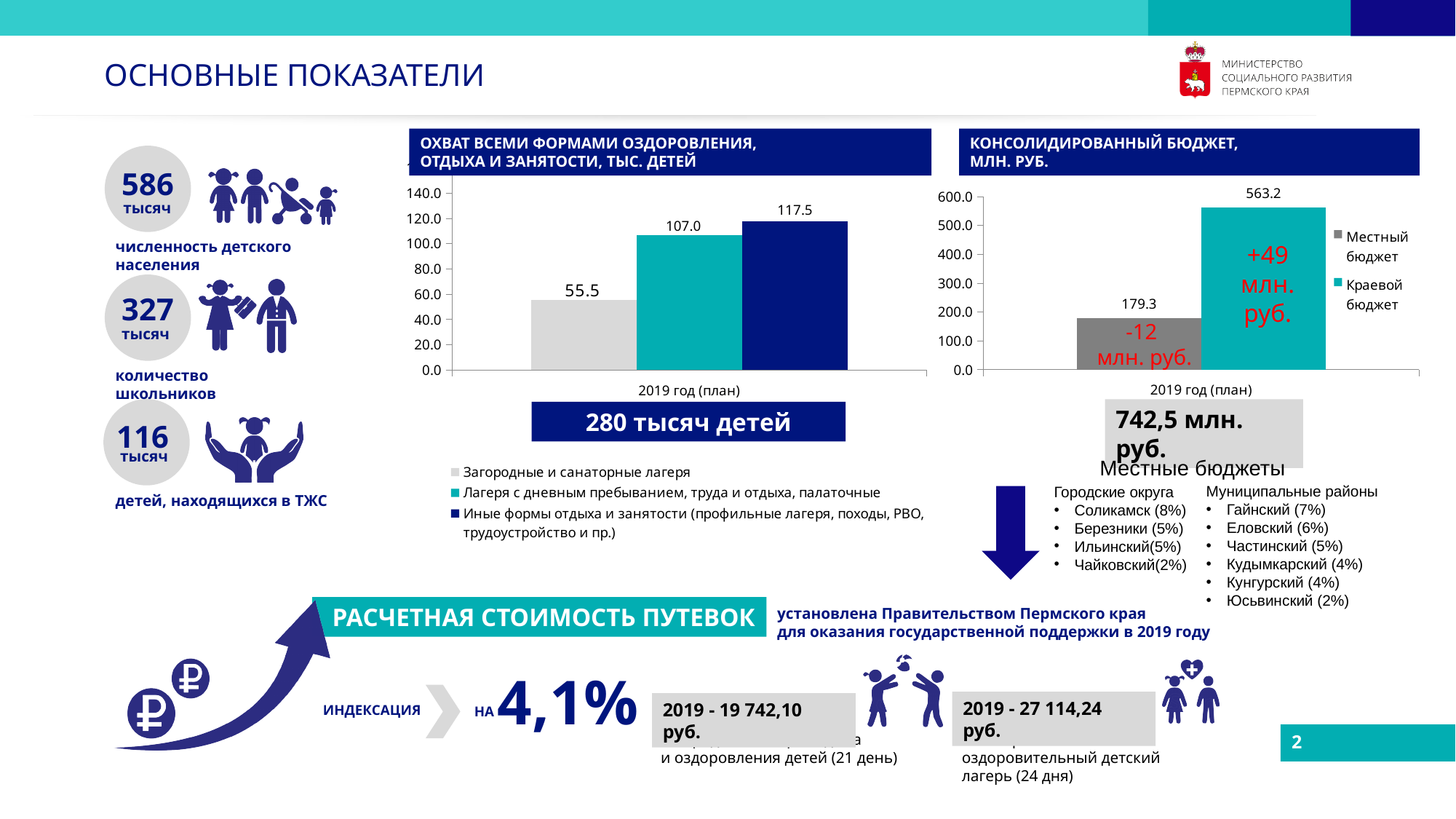
In the chart titled "КОНСОЛИДИРОВАННЫЙ БЮДЖЕТ, МЛН. РУБ.", what is the difference between "Краевой бюджет" and "Местный бюджет"? 383.9 What category label appears on the x axis of the chart titled "КОНСОЛИДИРОВАННЫЙ БЮДЖЕТ, МЛН. РУБ."? 2019 год (план) In the chart titled "КОНСОЛИДИРОВАННЫЙ БЮДЖЕТ, МЛН. РУБ.", what is the value for "Краевой бюджет"? 563.2 In the chart titled "ОХВАТ ВСЕМИ ФОРМАМИ ОЗДОРОВЛЕНИЯ, ОТДЫХА И ЗАНЯТОСТИ, ТЫС. ДЕТЕЙ", which series has the lowest value? Загородные и санаторные лагеря In the chart titled "ОХВАТ ВСЕМИ ФОРМАМИ ОЗДОРОВЛЕНИЯ, ОТДЫХА И ЗАНЯТОСТИ, ТЫС. ДЕТЕЙ", what is the value for "Лагеря с дневным пребыванием, труда и отдыха, палаточные"? 107.0 In the chart titled "ОХВАТ ВСЕМИ ФОРМАМИ ОЗДОРОВЛЕНИЯ, ОТДЫХА И ЗАНЯТОСТИ, ТЫС. ДЕТЕЙ", what is the difference between "Иные формы отдыха и занятости" and "Загородные и санаторные лагеря"? 62.0 How many series does the legend of the chart titled "ОХВАТ ВСЕМИ ФОРМАМИ ОЗДОРОВЛЕНИЯ, ОТДЫХА И ЗАНЯТОСТИ, ТЫС. ДЕТЕЙ" list? 3 What kind of chart is the chart titled "КОНСОЛИДИРОВАННЫЙ БЮДЖЕТ, МЛН. РУБ."? Bar chart In the chart titled "ОХВАТ ВСЕМИ ФОРМАМИ ОЗДОРОВЛЕНИЯ, ОТДЫХА И ЗАНЯТОСТИ, ТЫС. ДЕТЕЙ", which series has the highest value? Иные формы отдыха и занятости (профильные лагеря, походы, РВО, трудоустройство и пр.) In the chart titled "ОХВАТ ВСЕМИ ФОРМАМИ ОЗДОРОВЛЕНИЯ, ОТДЫХА И ЗАНЯТОСТИ, ТЫС. ДЕТЕЙ", what is the value for "Загородные и санаторные лагеря"? 55.5 In the chart titled "КОНСОЛИДИРОВАННЫЙ БЮДЖЕТ, МЛН. РУБ.", what is the value for "Местный бюджет"? 179.3 In the chart titled "КОНСОЛИДИРОВАННЫЙ БЮДЖЕТ, МЛН. РУБ.", which is larger, "Местный бюджет" or "Краевой бюджет"? Краевой бюджет